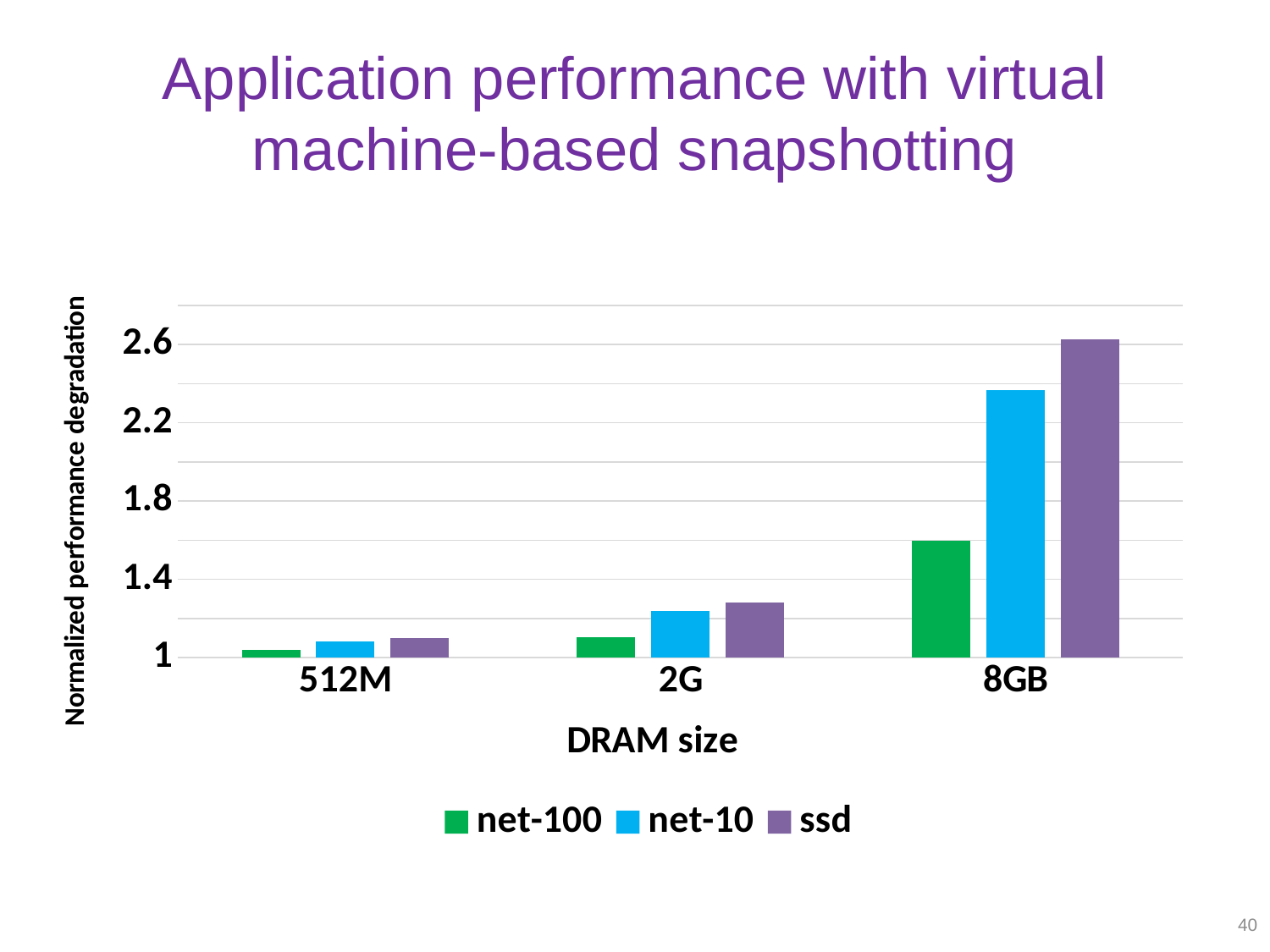
Is the value for net-100 at 8GB greater or less than 1.8? less Is the value for ssd at 2G greater or less than 1.4? less At 8GB, which is larger: the value for net-100 or the value for net-10? net-10 Is the value for ssd at 8GB greater or less than 2.2? greater Which DRAM size and series combination has the highest normalized performance degradation? ssd at 8GB What is the label of the y axis? Normalized performance degradation What kind of chart is shown on the slide? bar chart At 8GB, which is larger: the value for net-10 or the value for ssd? ssd How many DRAM size categories are shown on the x axis? 3 Which DRAM size and series combination has the lowest normalized performance degradation? net-100 at 512M How many series does the legend list? 3 Do the values for ssd rise or fall as DRAM size increases from 512M to 8GB? rise